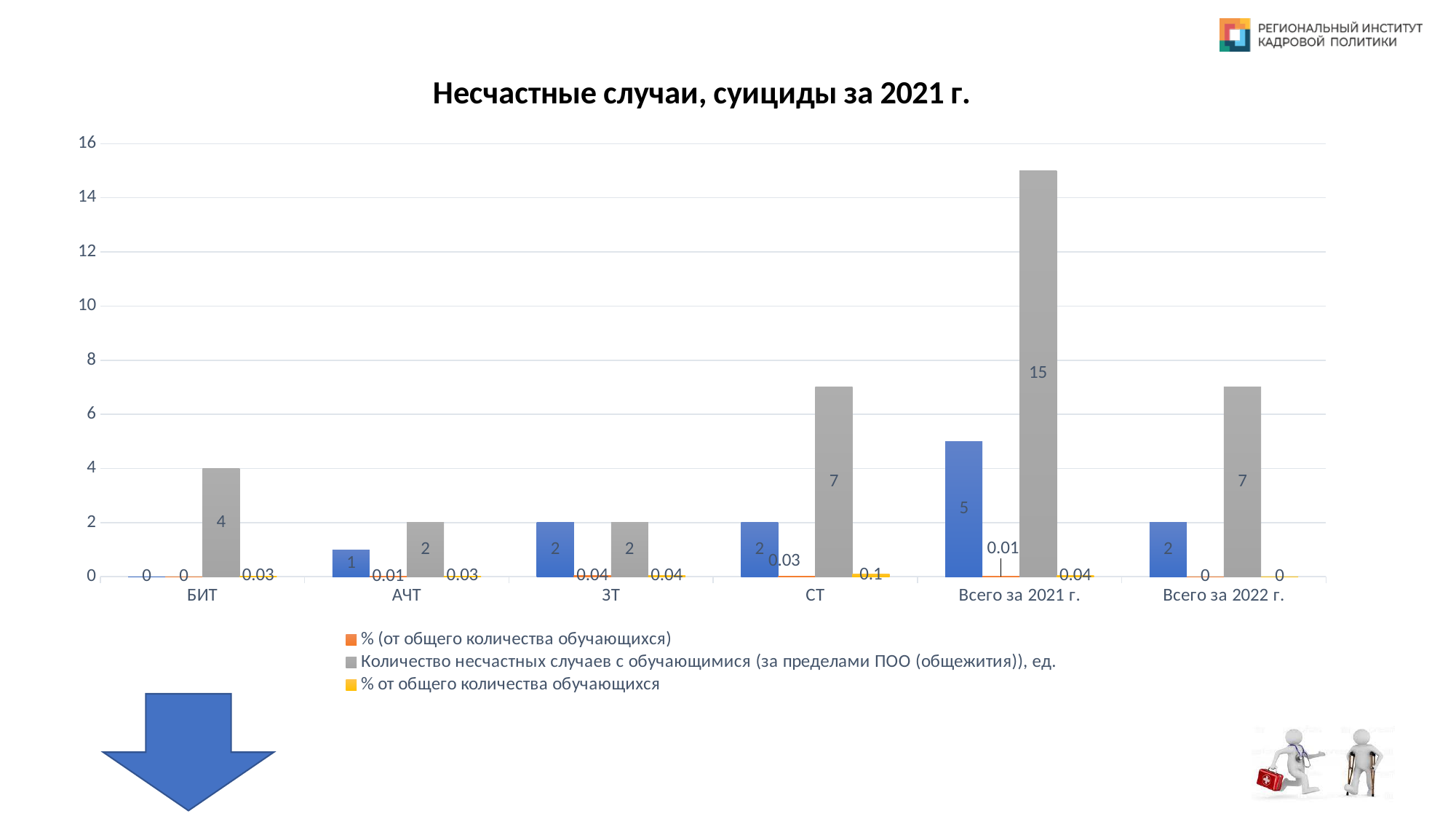
What is the title of the chart? Несчастные случаи, суициды за 2021 г. Is the grey bar value for Всего за 2021 г. greater or less than 14? greater Which has a larger grey bar value, СТ or БИТ? СТ How many categories are shown on the x axis? 6 What is the difference between the grey bar values for Всего за 2021 г. and Всего за 2022 г.? 8 What is the value of the blue bar for Всего за 2021 г.? 5 What is the value of the grey bar (Количество несчастных случаев с обучающимися) for Всего за 2021 г.? 15 What is the value of the grey bar (Количество несчастных случаев с обучающимися) for БИТ? 4 How many series does the legend list? 3 What kind of chart is shown on the slide? bar chart Which category has the highest grey bar (Количество несчастных случаев с обучающимися)? Всего за 2021 г. What is the value of the yellow bar (% от общего количества обучающихся) for СТ? 0.1